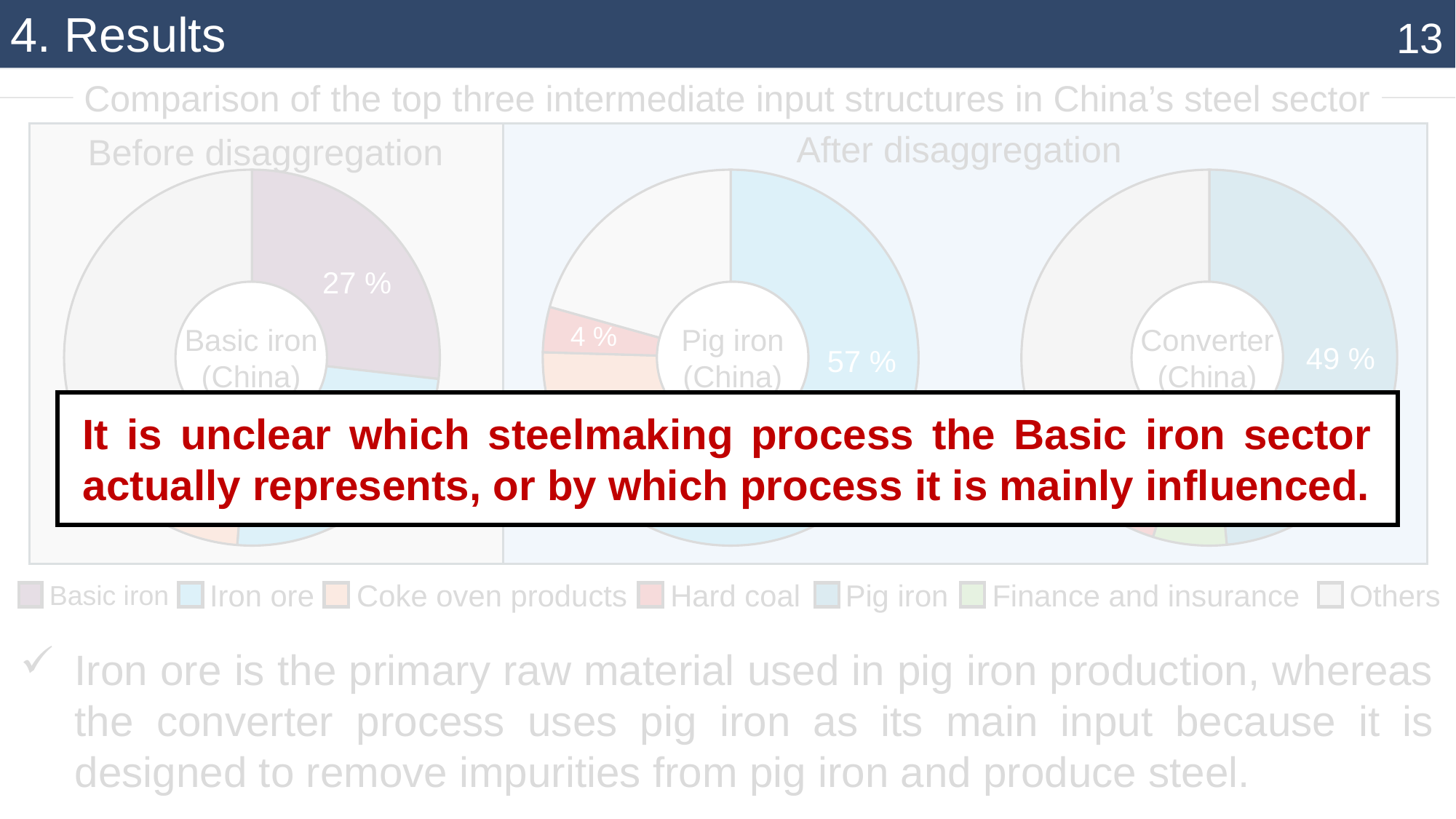
How many entries does the legend below the charts list? 7 In the Pig iron (China) chart, what is the difference between the 57 % slice and the 4 % slice? 53 % How many pie charts are shown on the slide? 3 What is the title above the three pie charts? Comparison of the top three intermediate input structures in China's steel sector What kind of chart is used to show the intermediate input structures on this slide? pie chart In the Pig iron (China) chart, what share is printed on the largest slice? 57 % In the Pig iron (China) chart, what share is printed on the small red slice? 4 % Which chart is shown under the heading 'Before disaggregation'? Basic iron (China) In the Converter (China) chart, what share is printed on the largest slice? 49 % Is the largest slice in the Pig iron (China) chart greater or less than 50 %? greater In the Basic iron (China) chart, what share is printed on the largest labelled slice? 27 % Which is larger: the 57 % slice in the Pig iron (China) chart or the 49 % slice in the Converter (China) chart? the 57 % slice in the Pig iron (China) chart